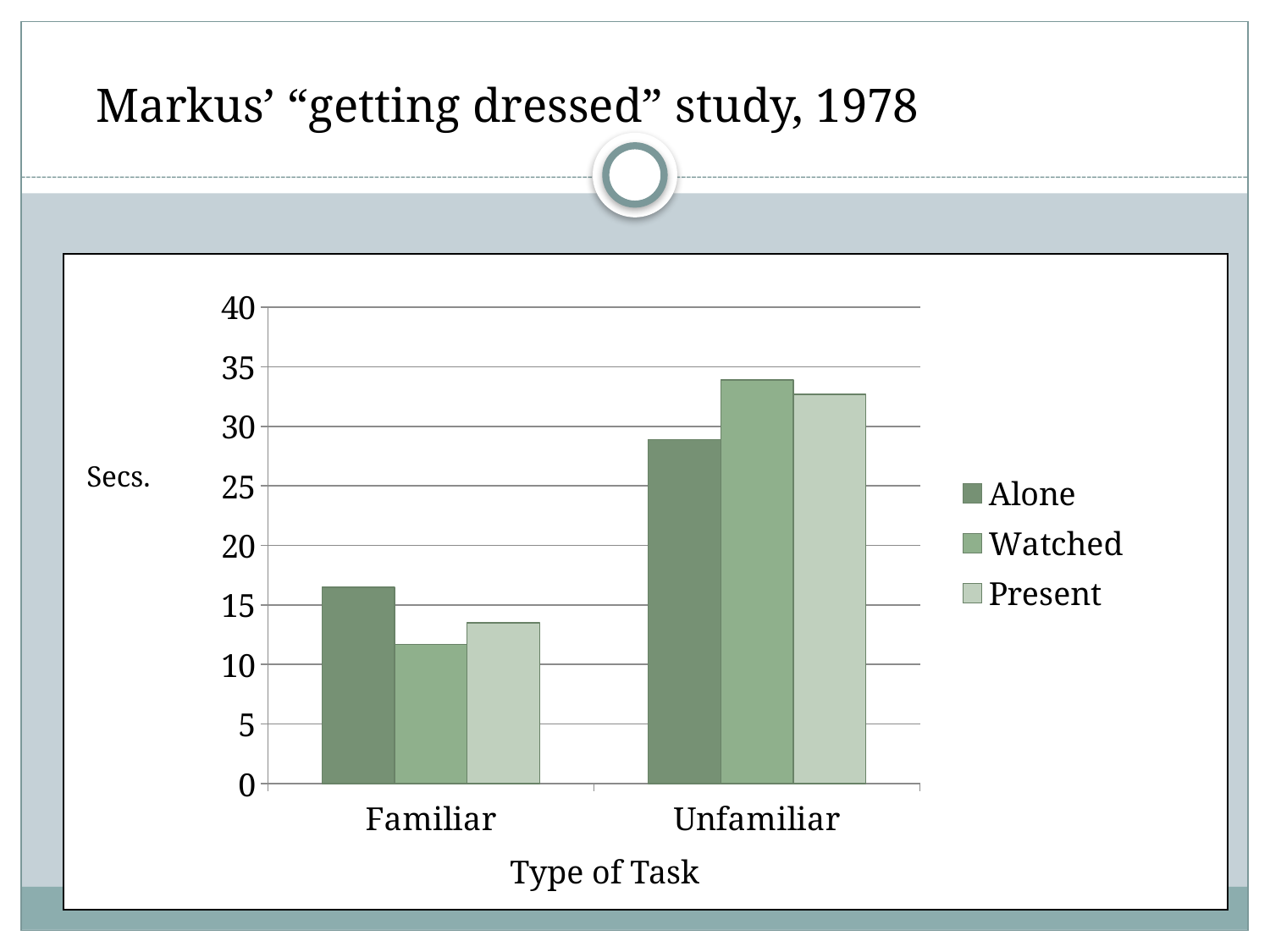
Is the value for Alone on the Unfamiliar task greater or less than 30? less Which bar is the lowest in the chart? Watched, Familiar Is the value for Watched on the Unfamiliar task greater or less than 30? greater What is the label of the x axis? Type of Task Is the value for Watched on the Familiar task greater or less than 15? less How many series does the legend list? 3 What kind of chart is shown on the slide? bar chart For the Unfamiliar task, which is larger: Alone or Watched? Watched How many task types are shown on the x axis? 2 What unit is shown on the y axis label? Secs. For the Familiar task, which is larger: Alone or Watched? Alone